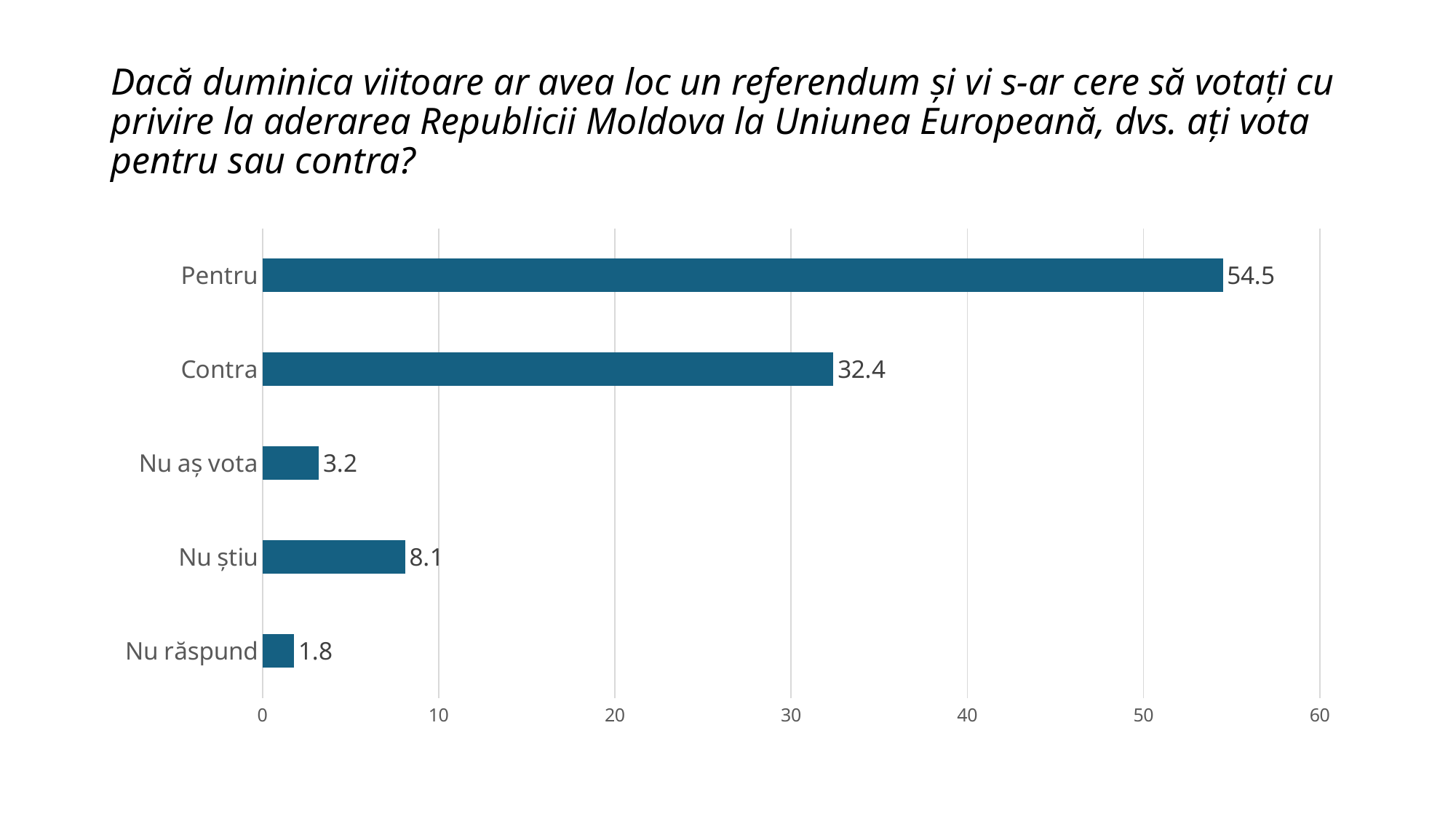
What is the value for Nu răspund? 1.8 What is the value for Pentru? 54.5 What kind of chart is shown on the slide? bar chart What is the value for Nu știu? 8.1 How many categories are shown in the chart? 5 Which category has the highest value? Pentru Which category has the lowest value? Nu răspund What is the highest tick value shown on the horizontal axis? 60 What is the difference between the values for Pentru and Contra? 22.1 Is the value for Contra greater or less than 30? greater Which is larger, the value for Nu aș vota or the value for Nu știu? Nu știu What is the value for Contra? 32.4